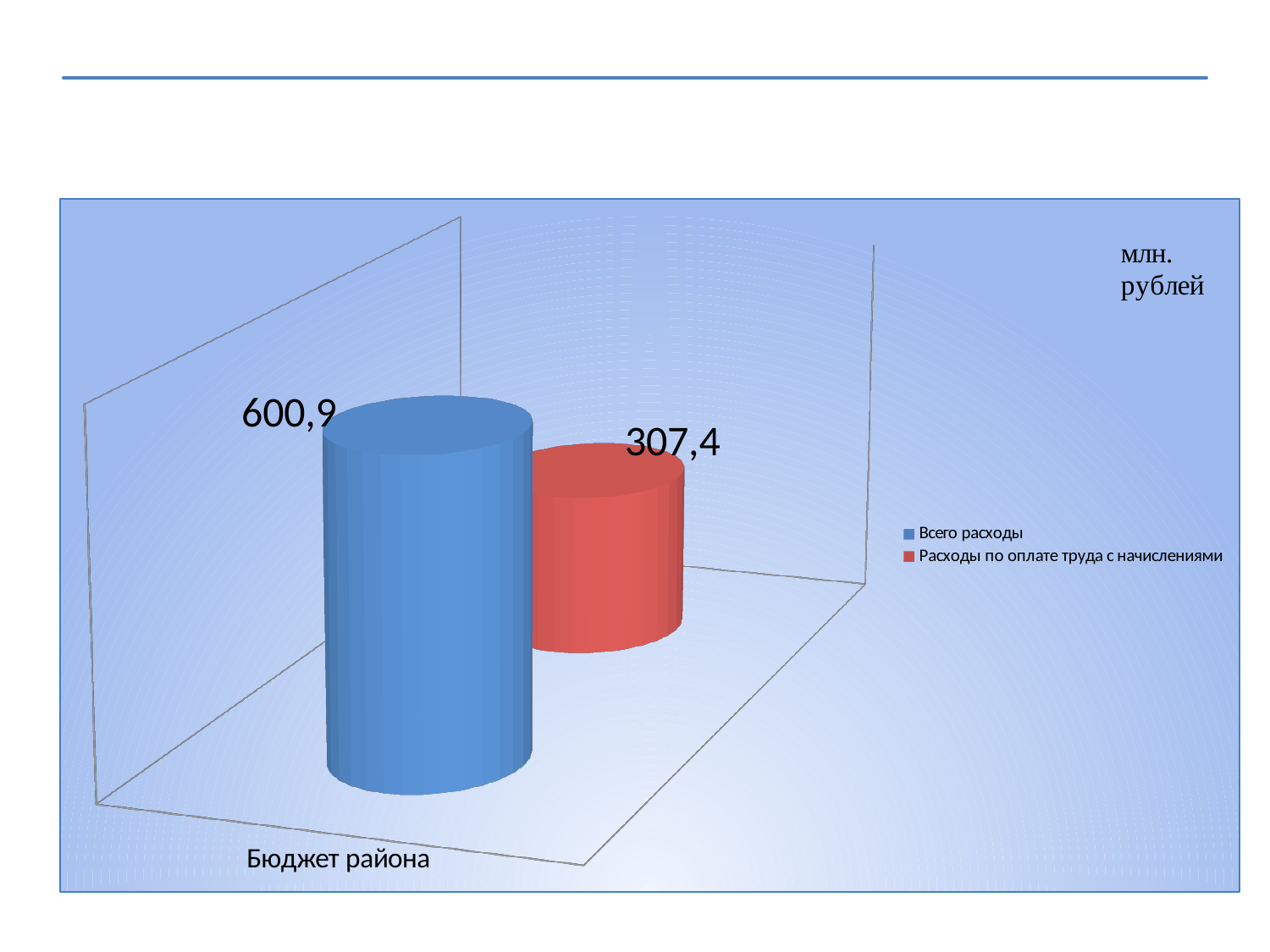
What is the difference between "Всего расходы" and "Расходы по оплате труда с начислениями"? 293,5 What unit is indicated in the top right corner of the chart? млн. рублей What kind of chart is shown on the slide? Bar chart How many series does the legend list? 2 Which series has the higher value? Всего расходы Which is larger: "Всего расходы" or "Расходы по оплате труда с начислениями"? Всего расходы How many categories are shown on the x axis? 1 What is the name of the category shown on the x axis? Бюджет района Which series has the lower value? Расходы по оплате труда с начислениями What is the value for "Всего расходы"? 600,9 What is the value for "Расходы по оплате труда с начислениями"? 307,4